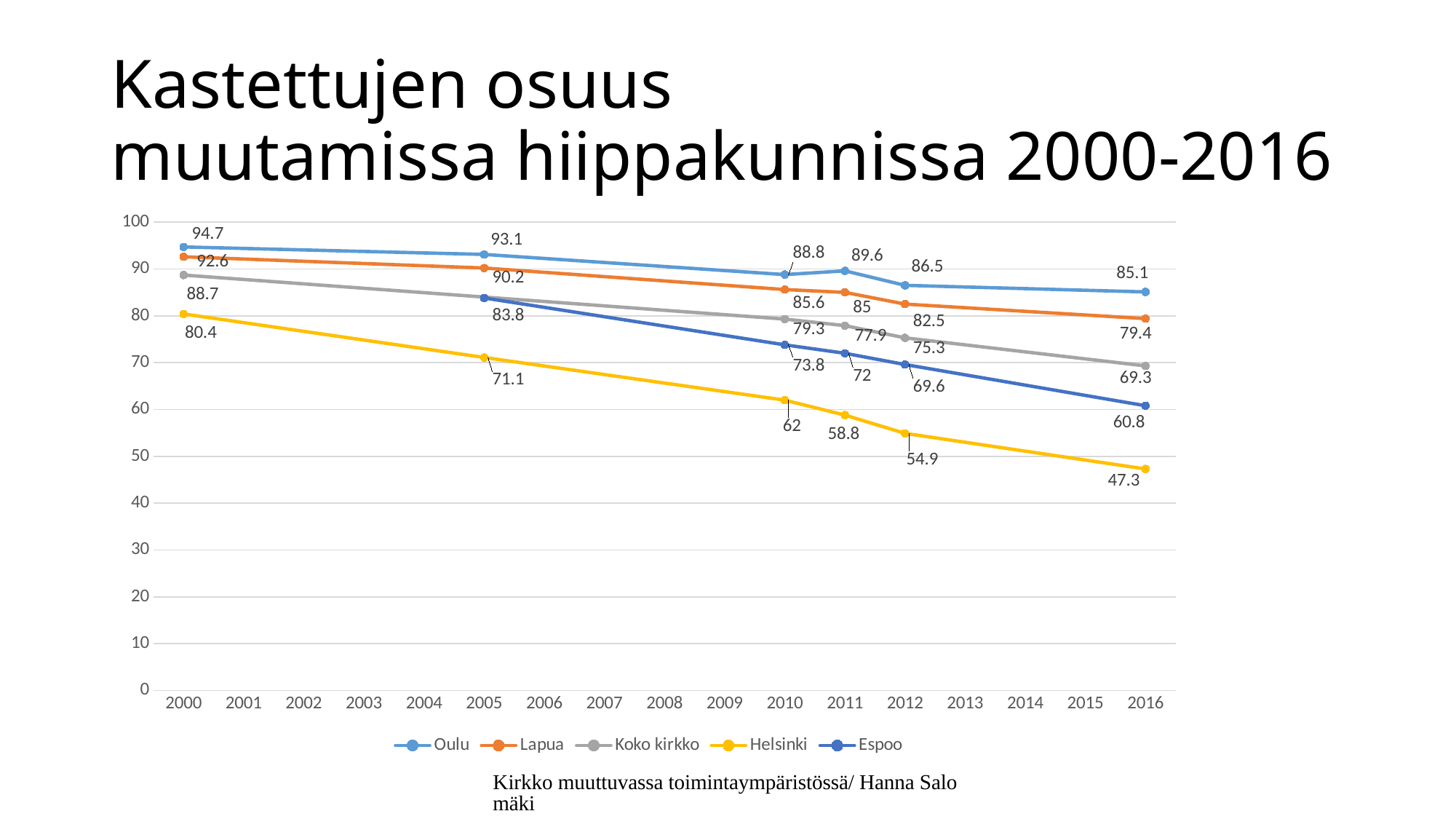
Which series has the lowest value in 2016? Helsinki What is the value for Espoo in 2012? 69.6 What is the value for Helsinki in 2016? 47.3 What is the value for Oulu in 2000? 94.7 What is the value for Lapua in 2010? 85.6 By how much did the value for Oulu fall from 2000 to 2016? 9.6 Does the value for Helsinki rise or fall from 2000 to 2016? fall Which series has the highest value in 2016? Oulu What kind of chart is shown on the slide? line chart In 2012, which is larger: the value for Koko kirkko or the value for Espoo? Koko kirkko What is the value for Koko kirkko in 2011? 77.9 How many series does the legend list? 5